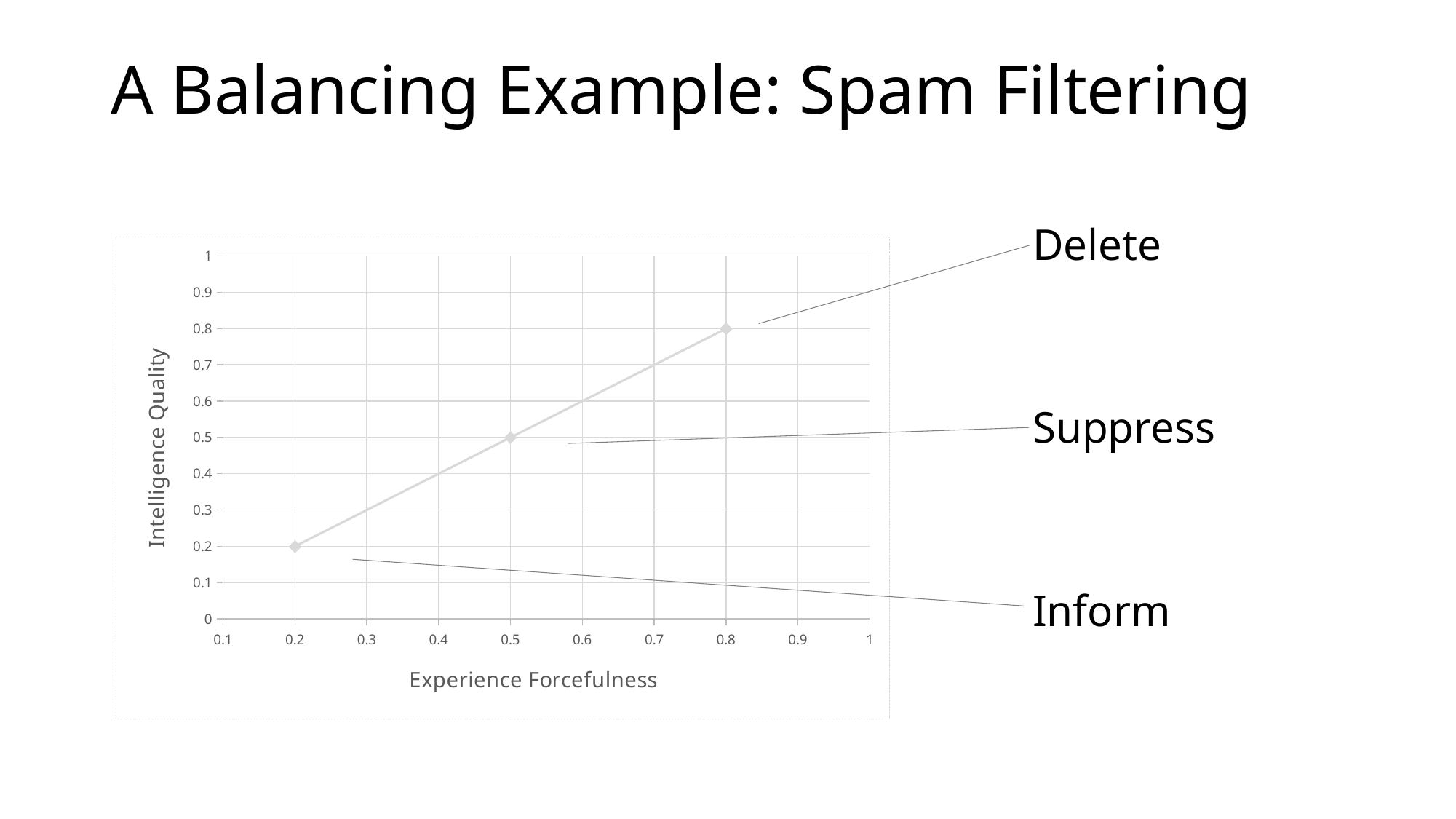
What kind of chart is shown on the slide? line chart How many data points are plotted on the chart? 3 Which labelled point has the highest Intelligence Quality? Delete Which has a higher Experience Forcefulness, the Suppress point or the Inform point? Suppress What is the difference in Intelligence Quality between the Delete point and the Inform point? 0.6 What is the Experience Forcefulness value of the point labelled Inform? 0.2 Do the plotted values rise or fall as Experience Forcefulness increases along the x axis? rise What is the title of the y axis? Intelligence Quality Which labelled point has the lowest Experience Forcefulness? Inform What is the Intelligence Quality value of the point labelled Suppress? 0.5 What is the title of the x axis? Experience Forcefulness What is the Intelligence Quality value of the point labelled Delete? 0.8